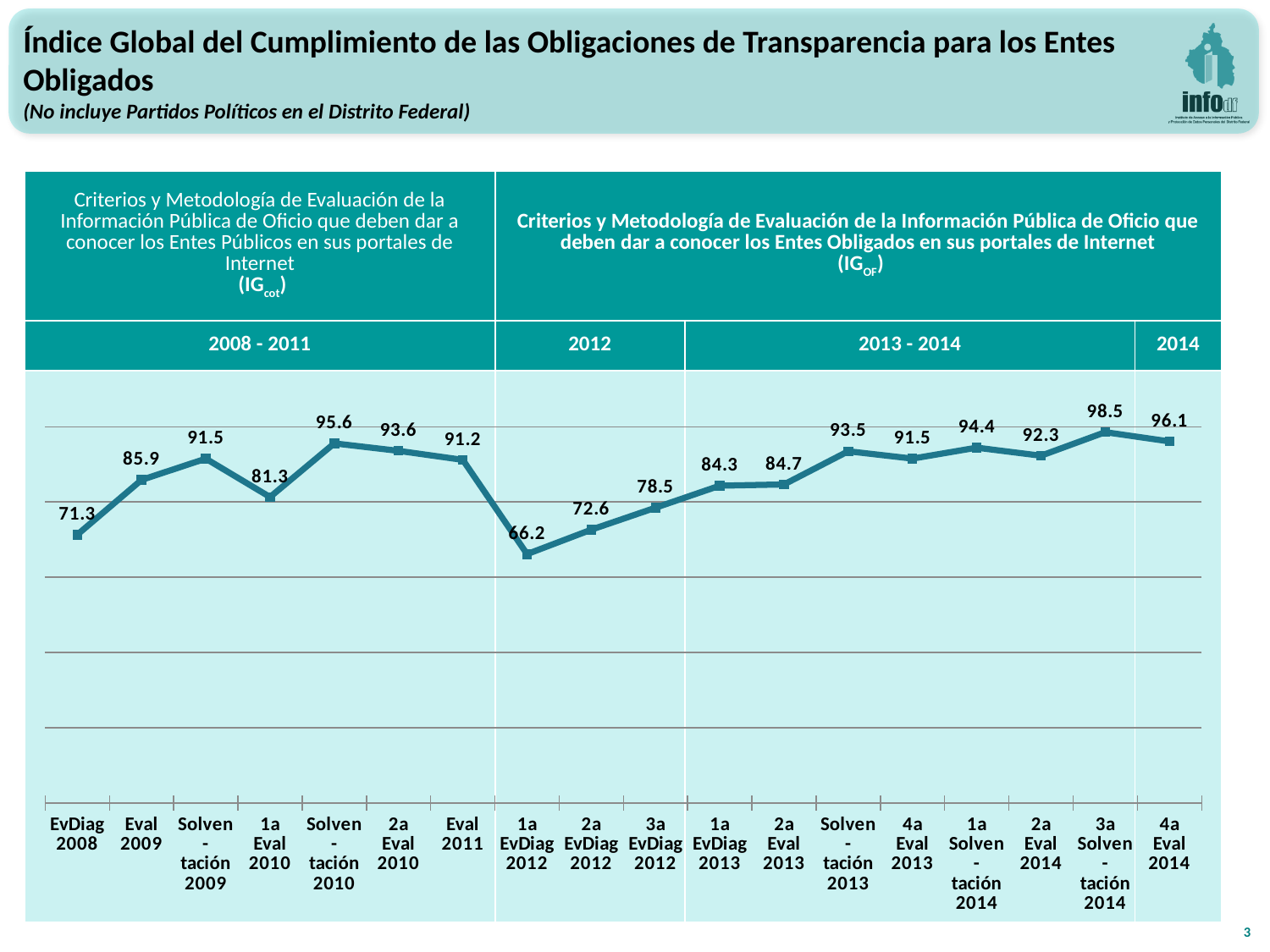
What is the value for 4a Eval 2014? 96.1 Which is larger, the value for Solventación 2010 or the value for 1a Eval 2010? Solventación 2010 What is the value for Solventación 2010? 95.6 Which point has the highest value? 3a Solventación 2014 How many data points are plotted on the line? 18 What is the value for 1a EvDiag 2012? 66.2 What is the difference between the highest value (3a Solventación 2014) and the lowest value (1a EvDiag 2012)? 32.3 What type of chart is shown on the slide? Line chart Which point has the lowest value? 1a EvDiag 2012 Do the values rise or fall from 1a EvDiag 2012 to 3a EvDiag 2012? Rise What is the value for EvDiag 2008? 71.3 What is the difference between the value for 4a Eval 2014 and the value for EvDiag 2008? 24.8